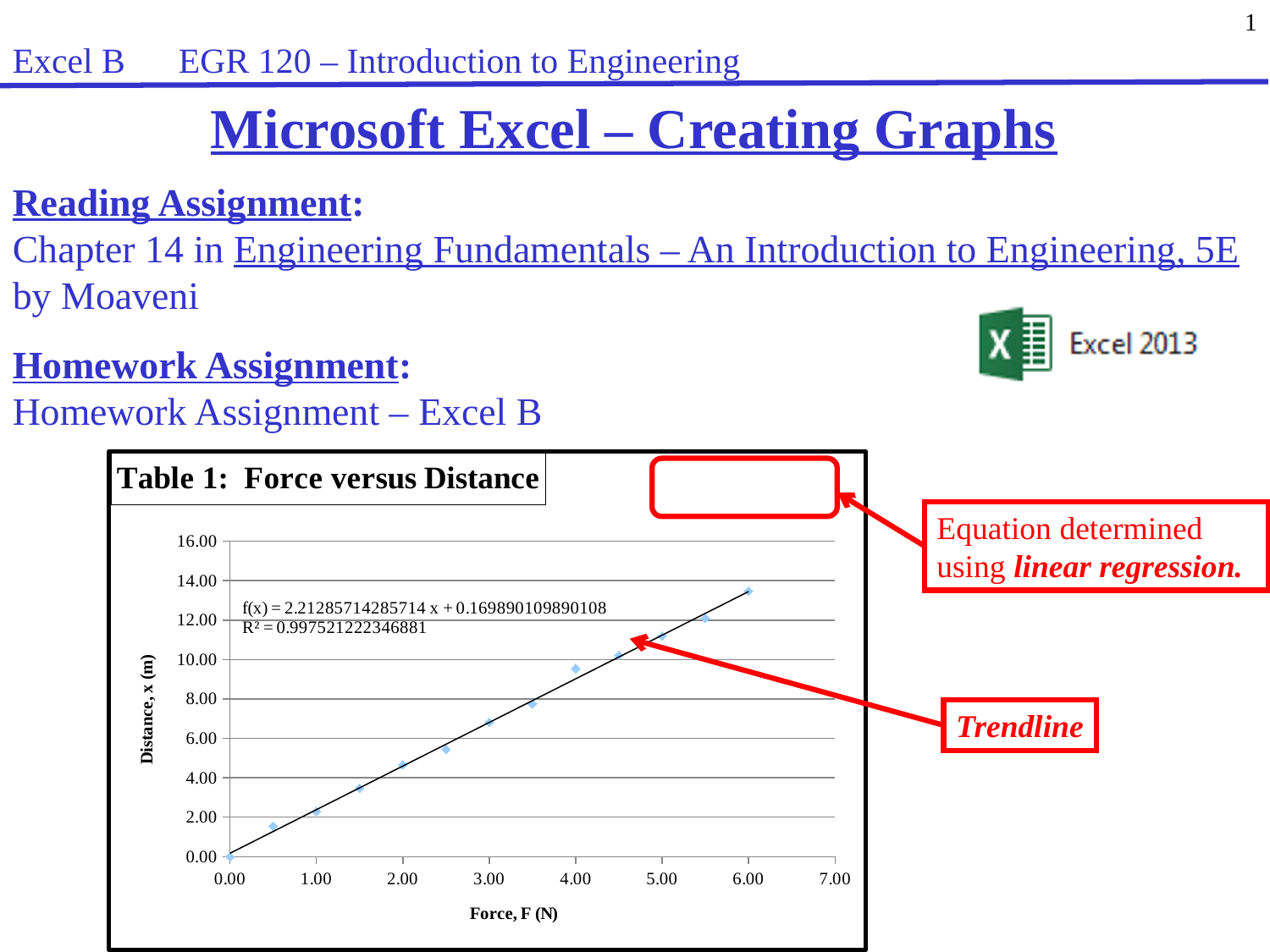
At which force value is the plotted distance highest? 6.00 Which has the larger distance value: the point at a force of 3.00 or the point at a force of 5.00? 5.00 At which force value is the plotted distance lowest? 0.00 Is the distance value at a force of 2.00 greater or less than 4.00? greater What is the R² value shown for the trendline on the chart? 0.997521222346881 What is the title of the chart on the slide? Table 1: Force versus Distance Is the distance value at a force of 6.00 greater or less than 12.00? greater What is the label of the x axis of the chart? Force, F (N) Is the distance value at a force of 4.00 greater or less than 10.00? less What kind of chart is shown on the slide? scatter chart How many data points are plotted on the chart? 13 Do the plotted distance values rise or fall as force increases along the x axis? rise